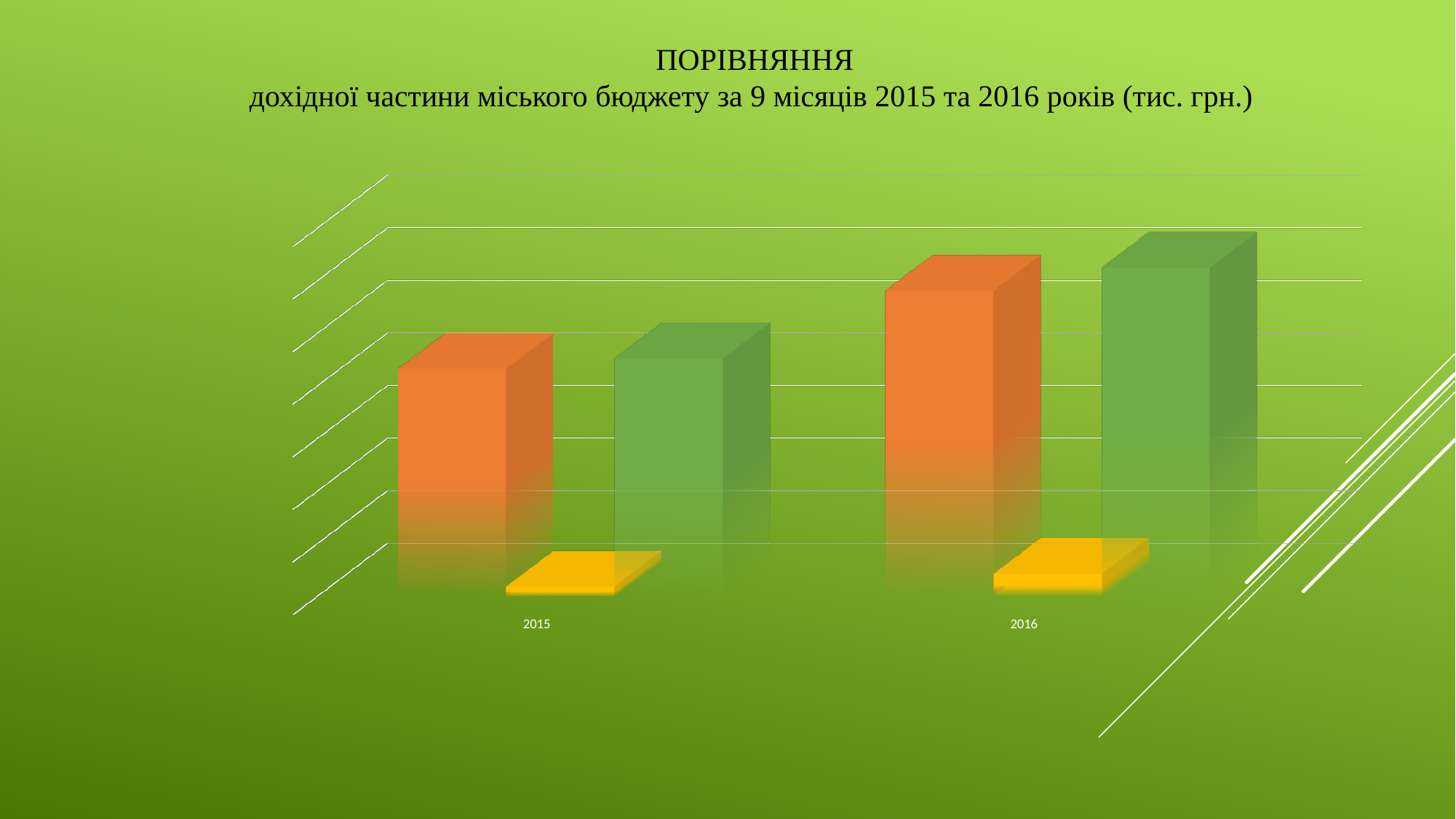
What unit does the slide title say the budget revenue is measured in? тис. грн. Which coloured bars are the lowest in both years? the yellow bars Do the orange and green bars rise or fall from 2015 to 2016? rise How many bars are plotted for each year on the chart? 3 What kind of chart is shown on the slide? bar chart How many categories (years) are shown on the x axis of the chart? 2 Is the orange bar for 2016 taller or shorter than the orange bar for 2015? taller Which years are shown as categories on the chart's x axis? 2015 and 2016 For which year is the green bar the tallest? 2016 For which year is the orange bar the tallest? 2016 Is the green bar for 2016 taller or shorter than the green bar for 2015? taller